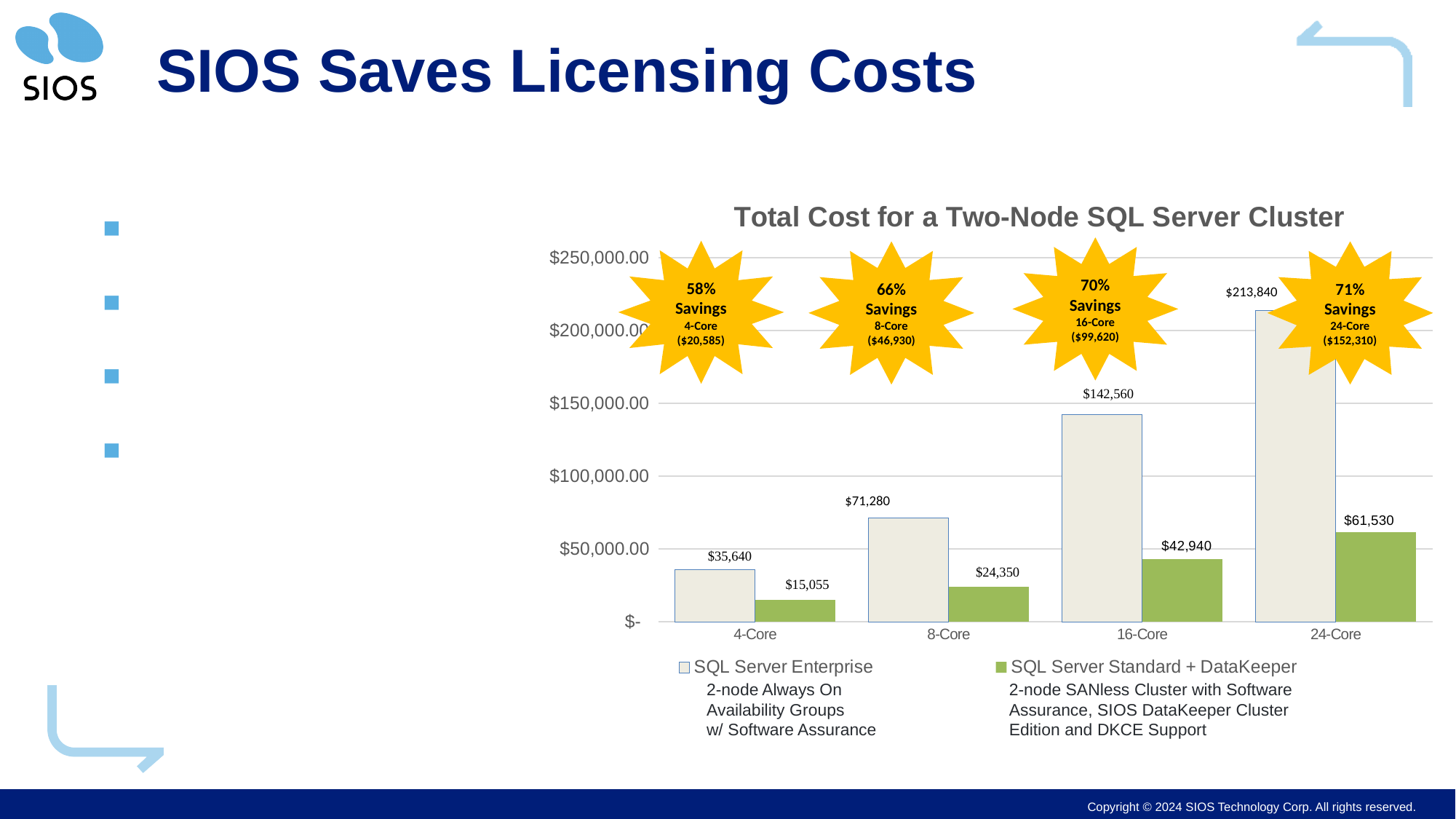
What is the SQL Server Enterprise cost for the 16-Core configuration? $142,560 Which core configuration has the highest SQL Server Enterprise cost? 24-Core What is the title of the chart? Total Cost for a Two-Node SQL Server Cluster Do the SQL Server Enterprise costs rise or fall as the core count increases from 4-Core to 24-Core? rise How many series does the chart legend list? 2 Which is larger for the 24-Core configuration: the SQL Server Enterprise cost or the SQL Server Standard + DataKeeper cost? SQL Server Enterprise What is the SQL Server Enterprise cost for the 24-Core configuration? $213,840 Which core configuration has the lowest SQL Server Standard + DataKeeper cost? 4-Core How many core configurations (categories) are shown on the x axis? 4 What type of chart is shown on the slide? bar chart What is the SQL Server Standard + DataKeeper cost for the 8-Core configuration? $24,350 What is the difference between the SQL Server Enterprise cost and the SQL Server Standard + DataKeeper cost for the 4-Core configuration? $20,585